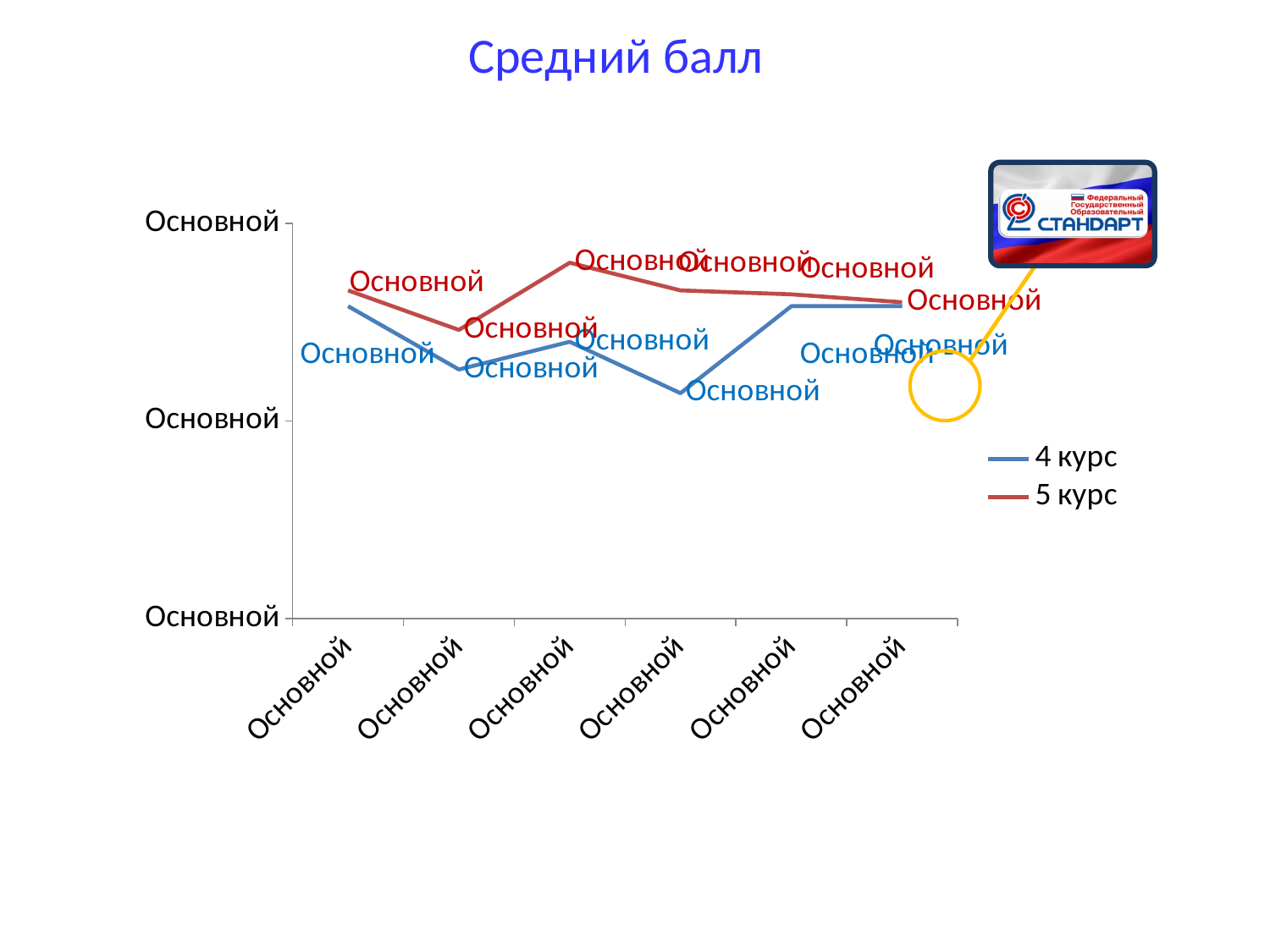
What are the series names listed in the legend? 4 курс, 5 курс What kind of chart is shown on the slide? line chart Which series has the lower values throughout the chart? 4 курс What is the title of the chart? Средний балл How many series does the legend list? 2 Which series is plotted above the other across the whole chart? 5 курс How many data points does each line have? 6